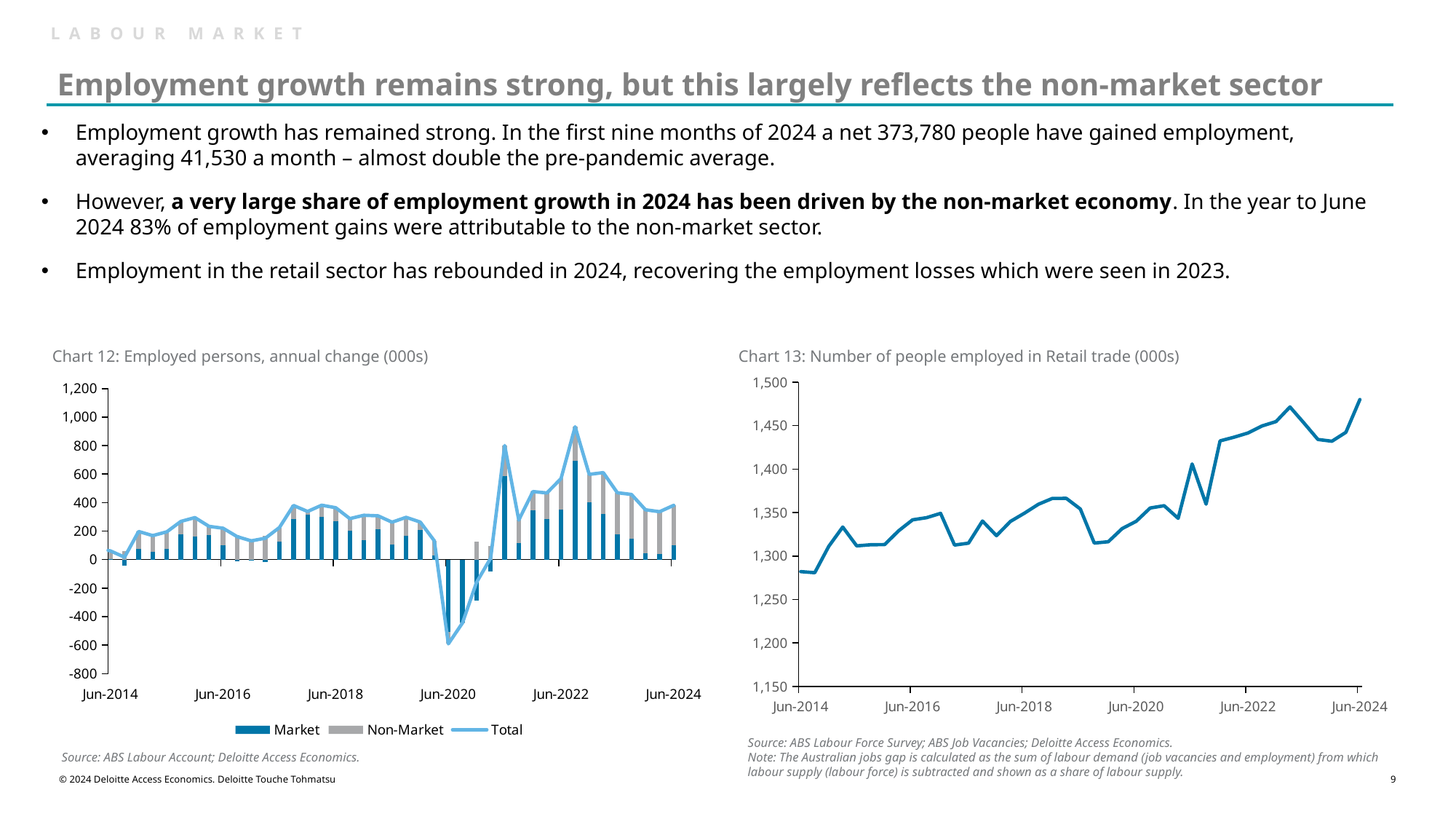
In Chart 13, is the value larger at Jun-2014 or at Jun-2024? Jun-2024 In Chart 12, is the Total value larger at Jun-2020 or at Jun-2022? Jun-2022 In Chart 12, is the Total value at Jun-2020 greater or less than -400? less In Chart 12, is the Total value at Jun-2024 greater or less than 200? greater What are the names of the series shown in the legend of Chart 12? Market, Non-Market, Total What kind of chart is Chart 12: Employed persons, annual change (000s)? bar chart with a line In Chart 13, is the value at Jun-2014 greater or less than 1,300? less How many series does the legend of Chart 12 list? 3 In Chart 13, do the values generally rise or fall from Jun-2014 to Jun-2024? rise What kind of chart is Chart 13: Number of people employed in Retail trade (000s)? line chart What is the title of the chart on the right of the slide? Chart 13: Number of people employed in Retail trade (000s)